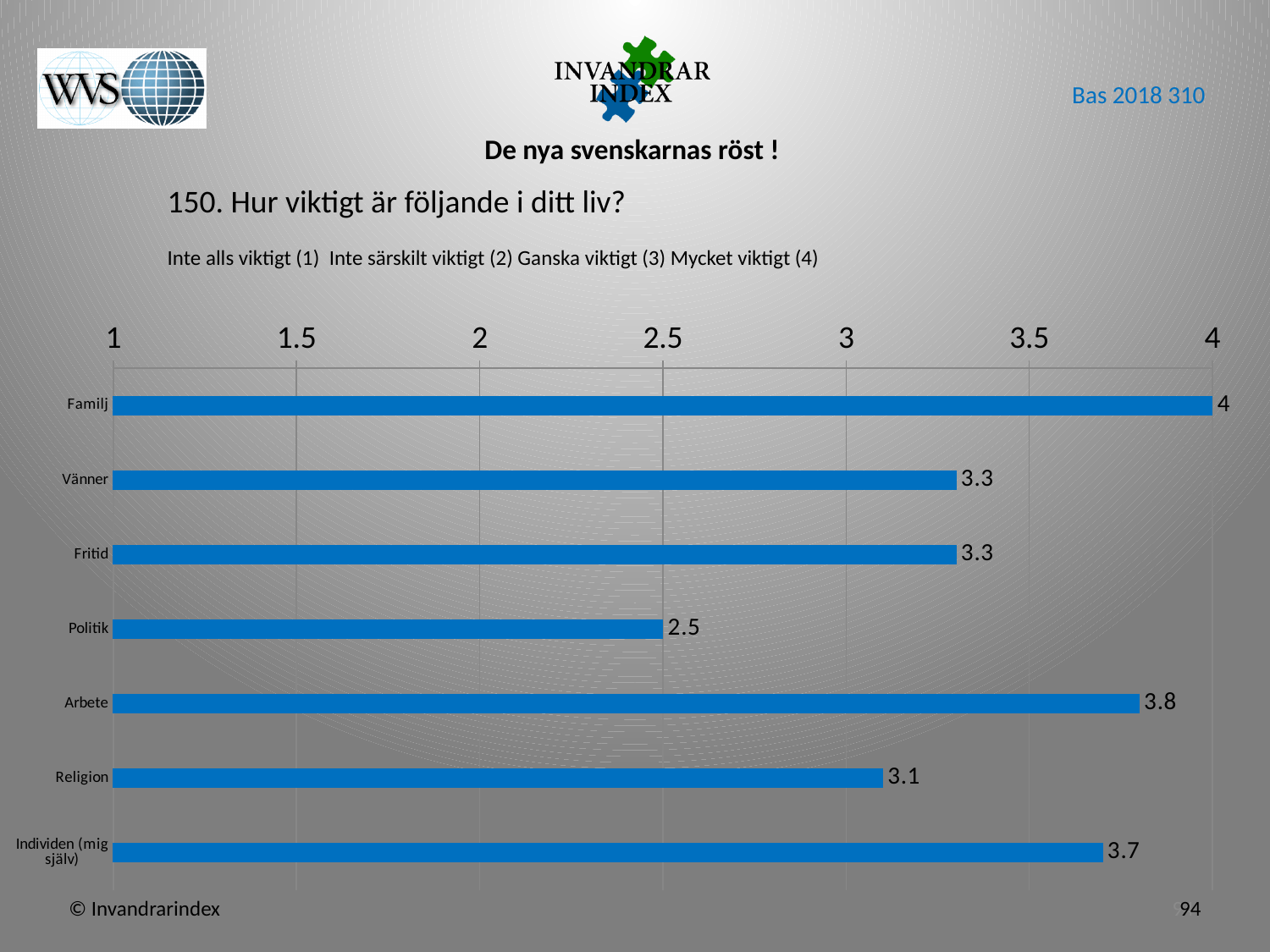
What is the value for Religion? 3.1 What is the value for Individen (mig själv)? 3.7 What is the value for Politik? 2.5 What is the value for Familj? 4 Is the value for Politik greater or less than 3? less How many categories are shown in the chart? 7 Which category has the highest value? Familj Which category has the lowest value? Politik What is the difference between the values for Arbete and Religion? 0.7 Which is larger, the value for Arbete or the value for Vänner? Arbete What is the maximum value shown on the chart's axis? 4 What kind of chart is shown on the slide? bar chart